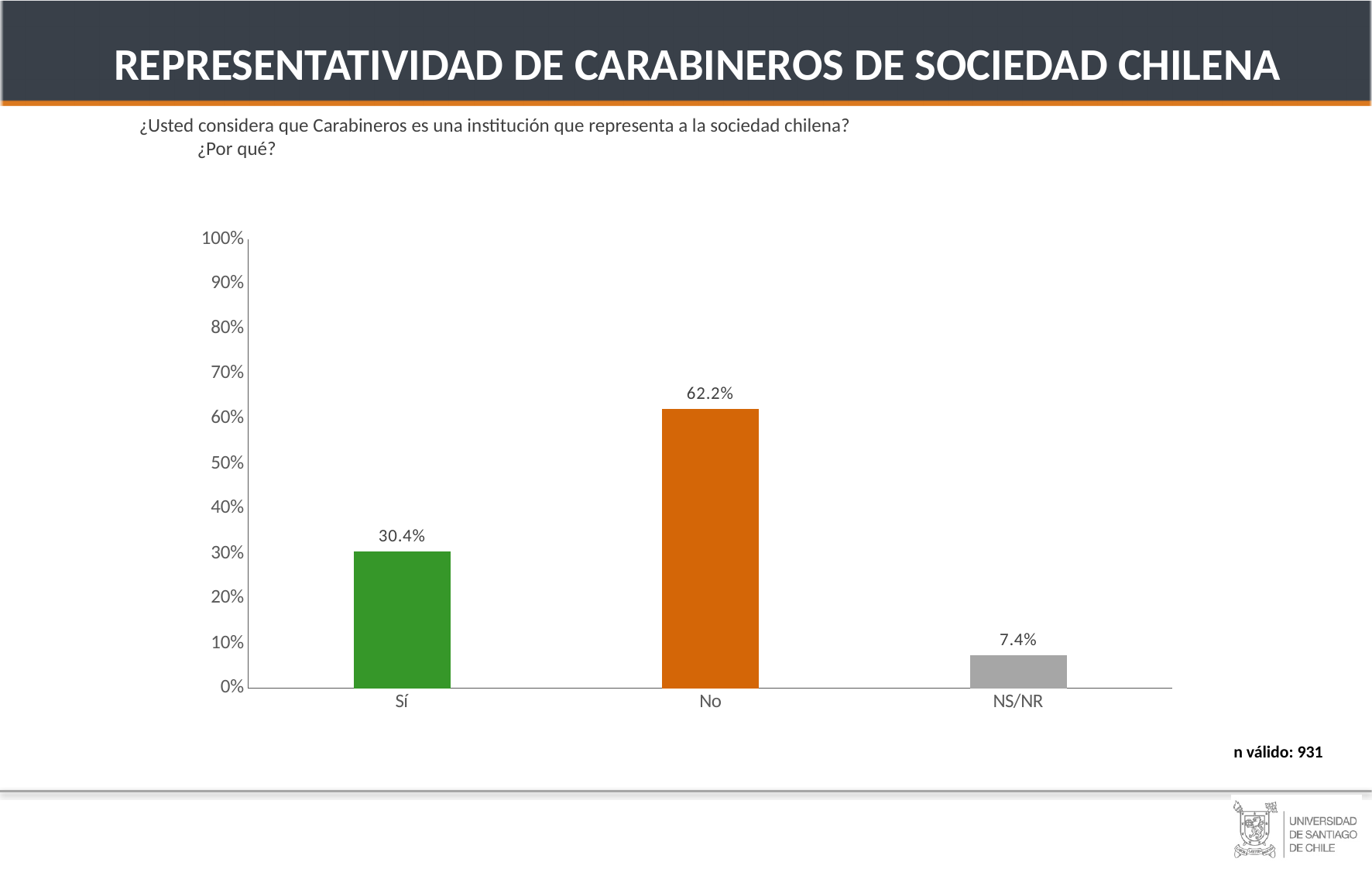
Which category has the lowest value? NS/NR Which category has the highest value? No What is the value for "NS/NR"? 7.4% What is the value for "No"? 62.2% What kind of chart is shown on the slide? bar chart What is the difference between the values for "Sí" and "NS/NR"? 23.0% Is the value for "No" greater or less than 50%? greater How many categories are shown on the x axis? 3 What is the difference between the values for "No" and "Sí"? 31.8% What colour is the bar for "No"? orange Which is larger, the value for "Sí" or the value for "No"? No What is the value for "Sí"? 30.4%